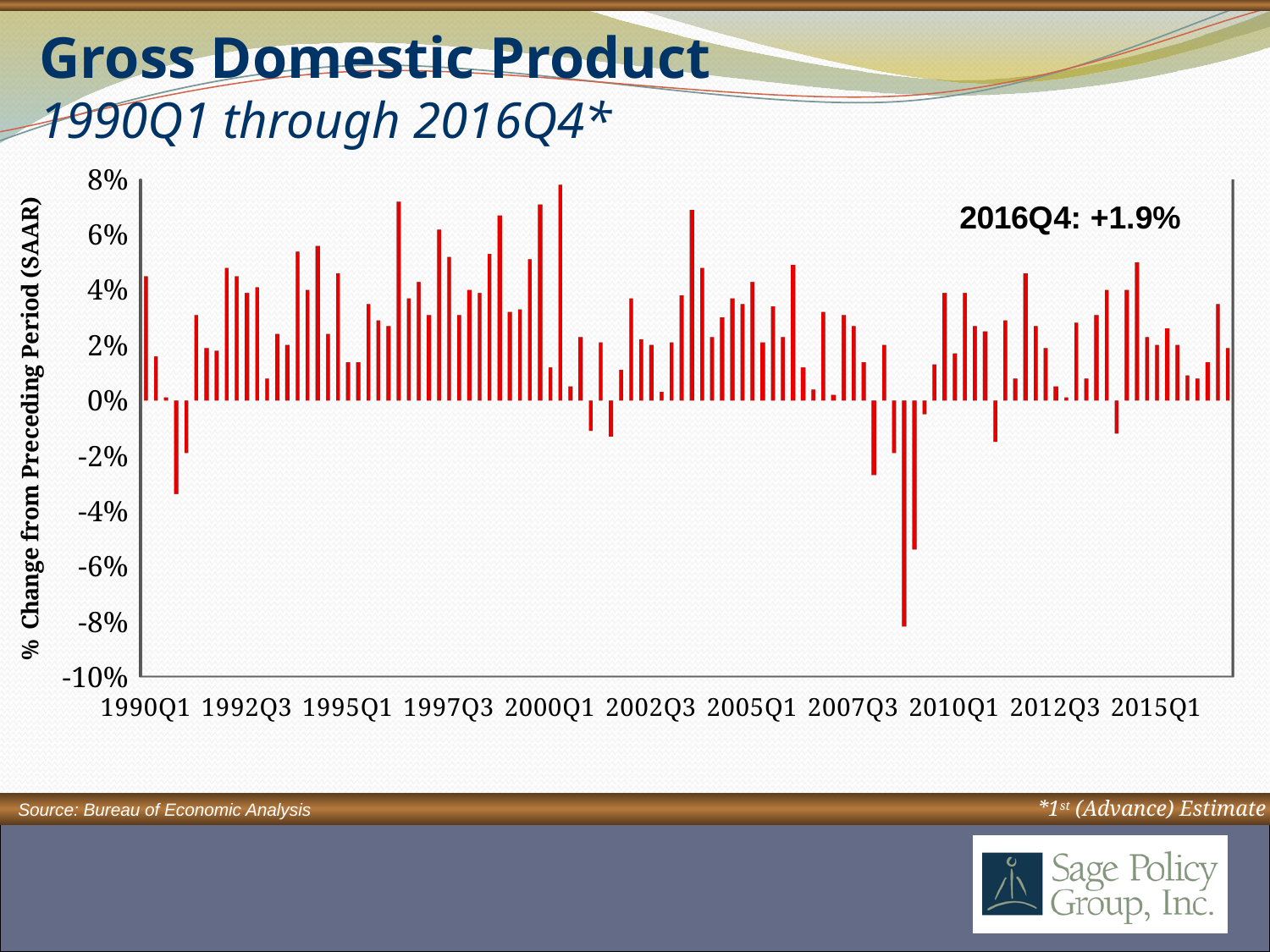
What is the first quarter label shown on the x axis? 1990Q1 What is the highest tick value shown on the vertical axis? 8% Is the lowest value on the chart greater or less than -6%? less What is the value shown for 2016Q4? +1.9% What kind of chart is shown on the slide? bar chart Is the value for 1990Q1 greater or less than 2%? greater What is the title of the chart? Gross Domestic Product Is the highest value on the chart greater or less than 6%? greater What is the label on the vertical axis of the chart? % Change from Preceding Period (SAAR) How many quarter labels are printed along the x axis? 11